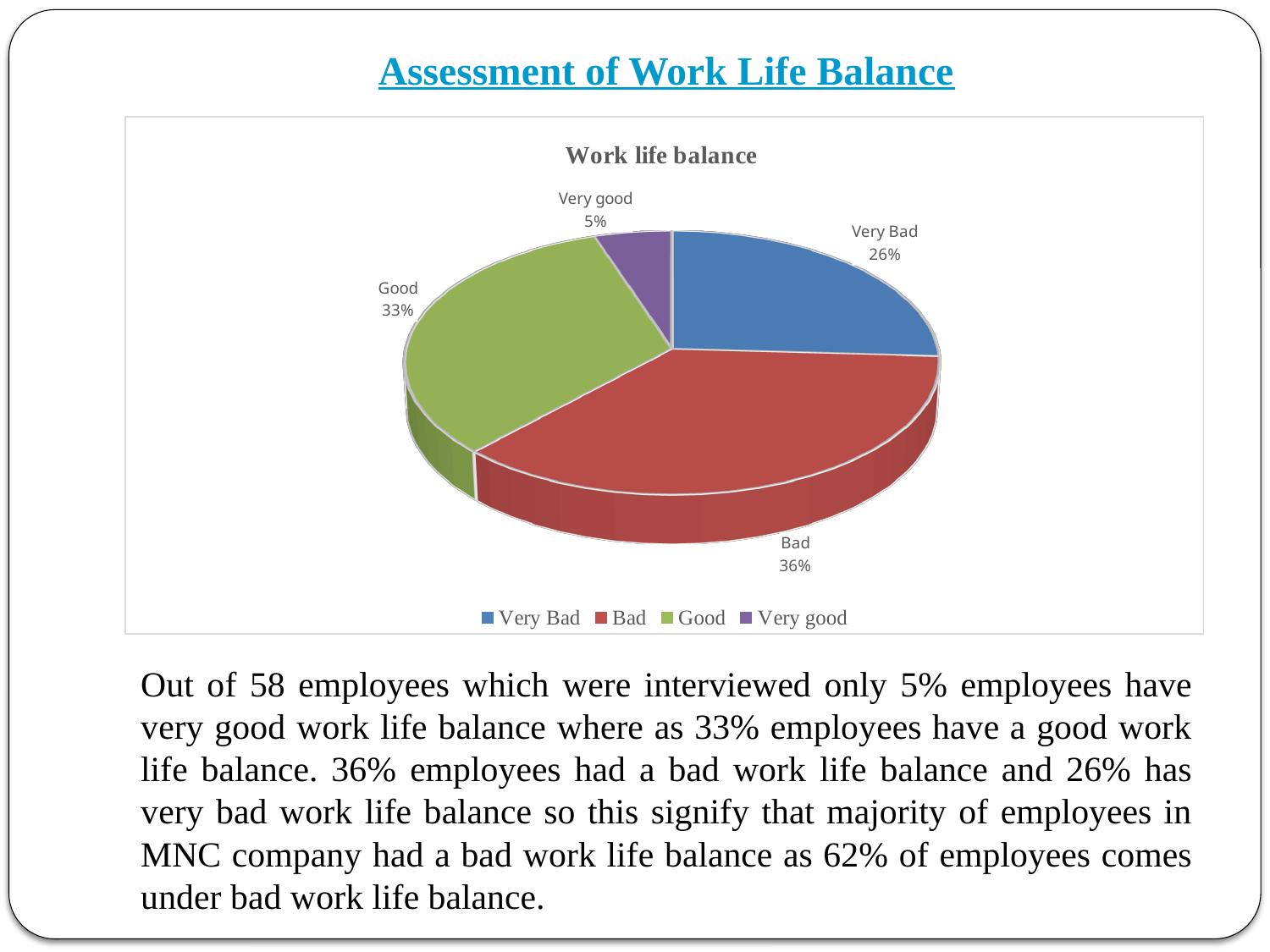
Which category has the smallest share of the pie? Very good What percentage of employees have a Very Bad work life balance? 26% What colour is the Good slice in the pie chart? green What is the chart's title? Work life balance What percentage of employees have a Bad work life balance? 36% How many categories does the pie chart have? 4 What is the difference in percentage points between the Bad and Very Bad slices? 10 What percentage of employees have a Good work life balance? 33% Which category has the largest share of the pie? Bad What percentage of employees have a Very good work life balance? 5% Which slice is larger, Good or Very Bad? Good What type of chart is shown on the slide? pie chart